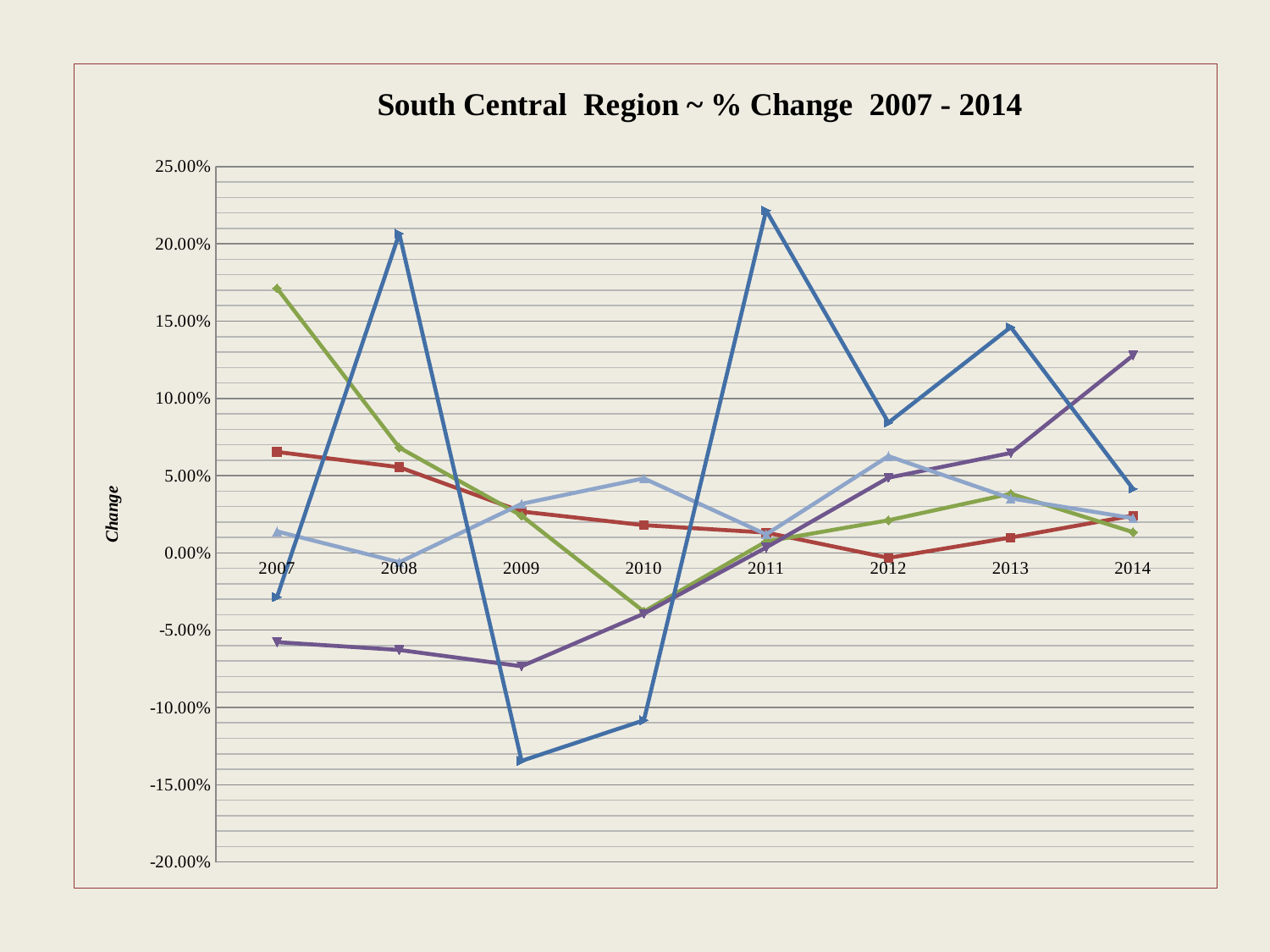
How many years are shown along the x axis of the chart? 8 In which year does the dark blue line reach its lowest value? 2009 Does the purple line rise or fall from 2009 to 2014? rise What is the label on the vertical axis of the chart? Change How many lines are plotted on the chart? 5 What is the title of the chart? South Central Region ~ % Change 2007 - 2014 Is the value of the green line in 2007 greater or less than 15.00%? greater Is the value of the purple line in 2014 greater or less than 10.00%? greater Is the value of the dark blue line in 2009 greater or less than -10.00%? less What kind of chart is shown on the slide? line chart In which year does the purple line reach its highest value? 2014